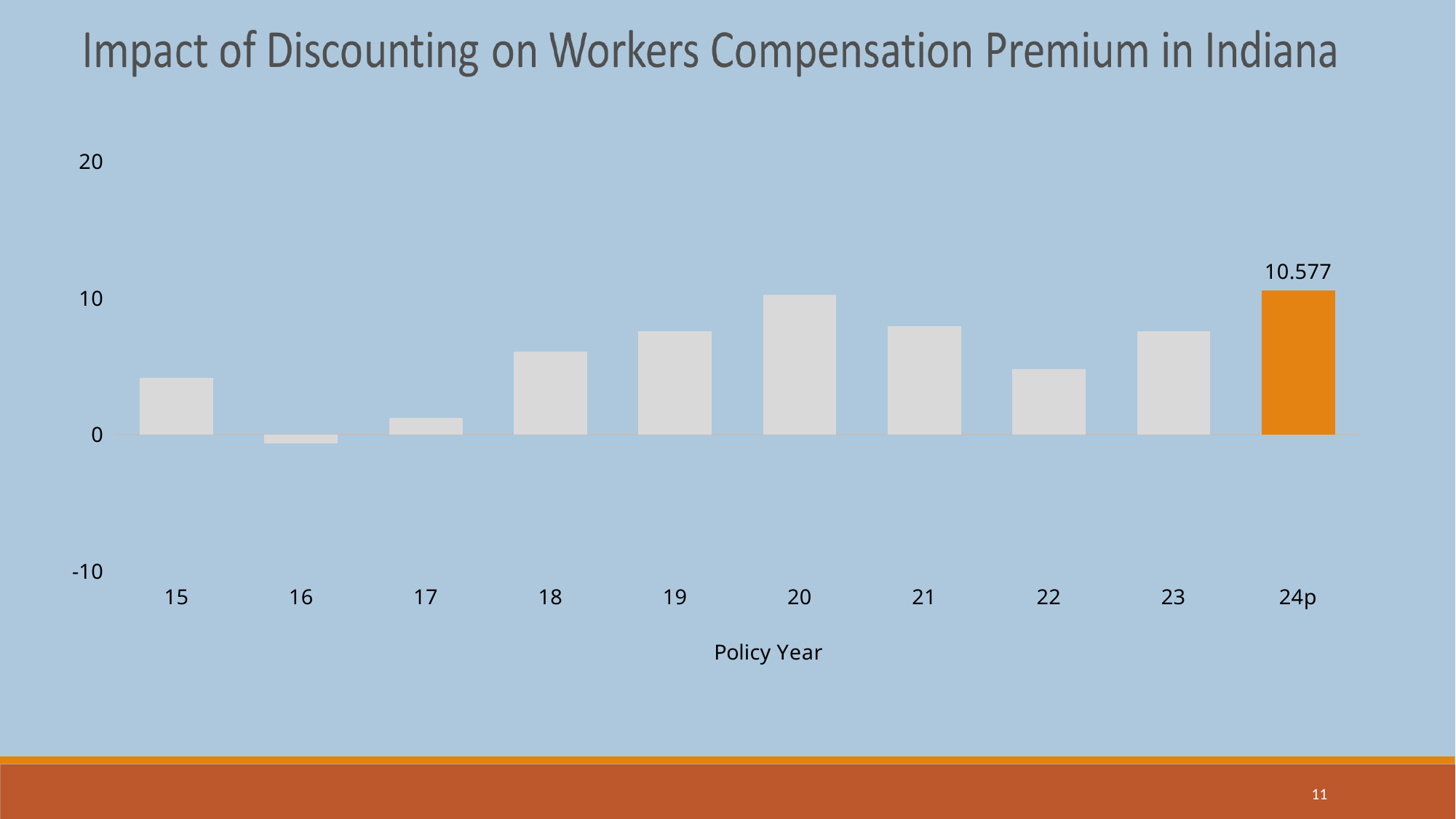
Is the value for policy year 21 greater or less than 10? less Is the value for policy year 15 greater or less than 0? greater What kind of chart is shown on the slide? bar chart What is the title of the x axis? Policy Year Which is larger, the value for policy year 17 or policy year 18? 18 How many policy years are shown on the x axis? 10 Which policy year has the lowest value? 16 Is the value for policy year 16 greater or less than 0? less Which is larger, the value for policy year 19 or policy year 22? 19 What is the value for policy year 24p? 10.577 Which policy year's bar is coloured orange? 24p